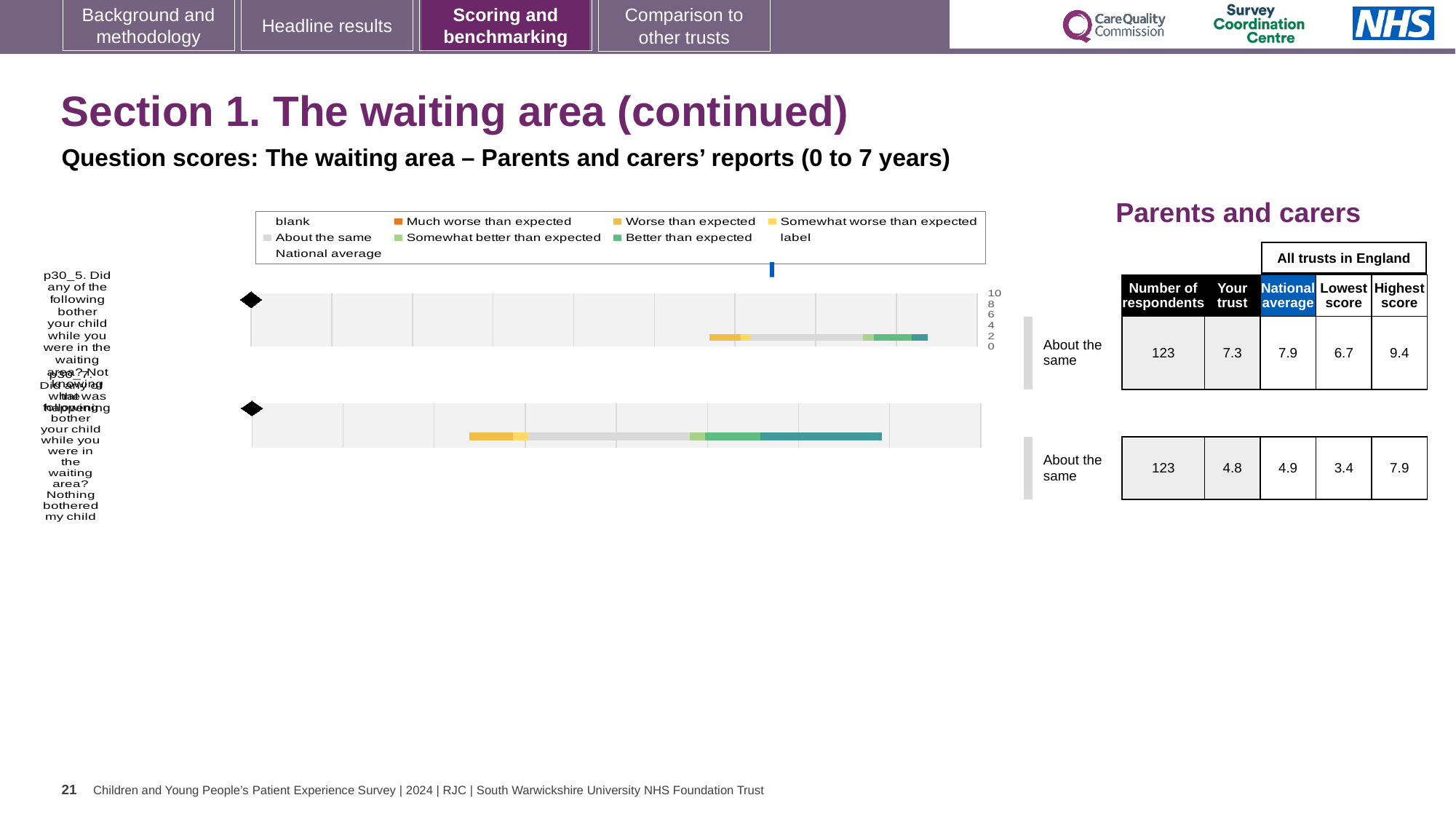
How many entries does the chart legend list? 9 How many question bars are plotted in the chart? 2 Which legend entry is shown in light grey? About the same What kind of chart is shown on the slide? bar chart What is the highest score among all trusts in England for the second question (p30_7)? 7.9 Which legend entry is shown in orange? Much worse than expected What is the national average score for the first question (p30_5)? 7.9 Which question has the higher 'Your trust' score, p30_5 or p30_7? p30_5 What is the 'Your trust' score for the first question (p30_5, Not knowing what was happening)? 7.3 What is the 'Your trust' score for the second question (p30_7, Nothing bothered my child)? 4.8 How many respondents answered each of the two questions? 123 What is the lowest score among all trusts in England for the first question (p30_5)? 6.7